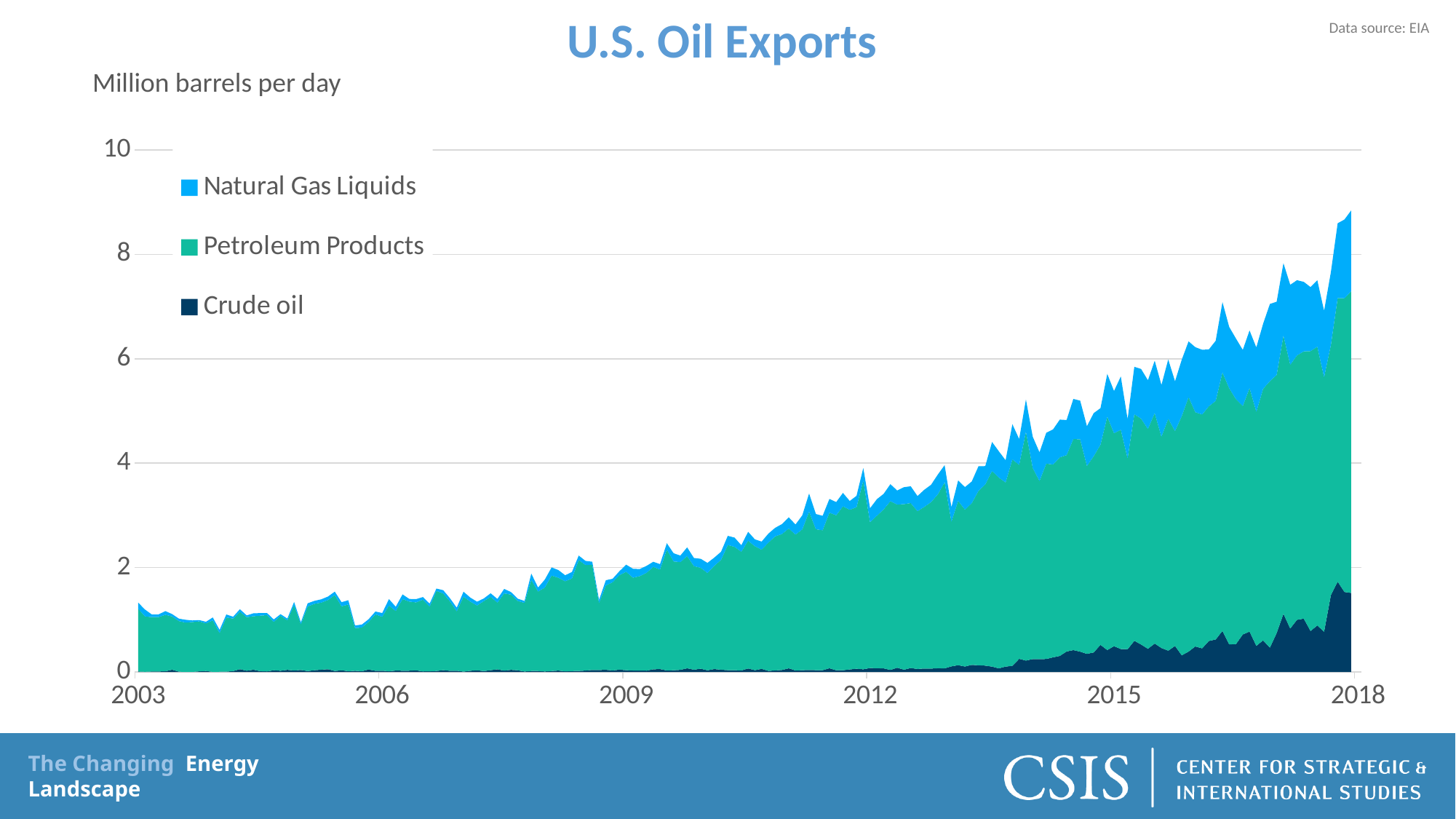
Do total U.S. oil exports rise or fall from 2003 to 2018? Rise What is the title of the chart? U.S. Oil Exports Is the total value of exports in 2015 greater or less than 4? greater What kind of chart is shown on the slide? Stacked area chart Is the total value of exports at the end of the chart in 2018 greater or less than 8? greater Is the total value of exports in 2003 greater or less than 2? less What unit is the y axis measured in? Million barrels per day Which series accounts for the smallest share of exports across the chart? Crude oil How many series does the legend list? 3 Which series accounts for the largest share of exports across the chart? Petroleum Products